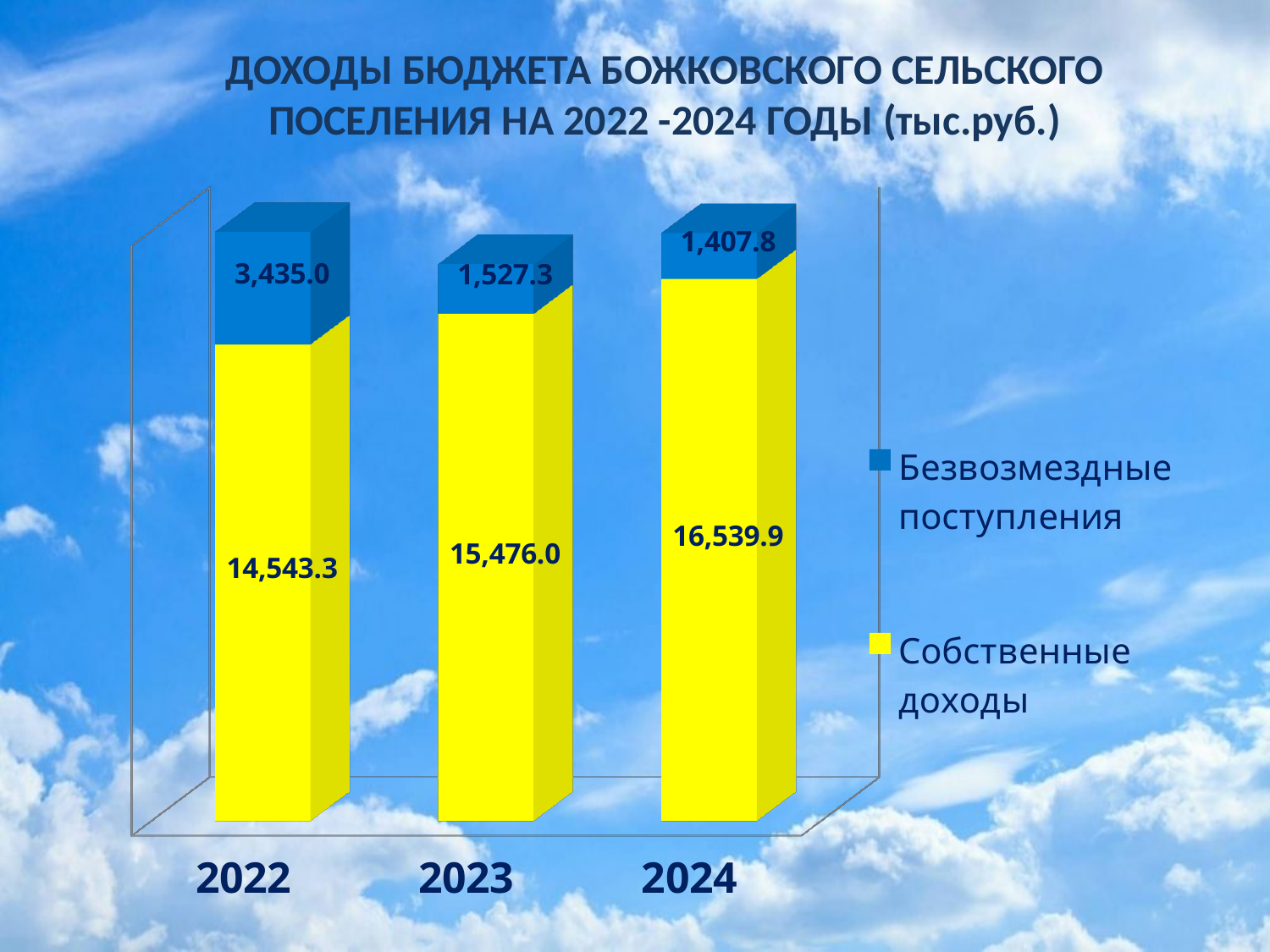
How many years are shown on the x axis? 3 In which year is Собственные доходы the highest? 2024 What is the value of Безвозмездные поступления for 2023? 1,527.3 What is the difference between Собственные доходы in 2024 and in 2022? 1,996.6 What is the value of Безвозмездные поступления for 2024? 1,407.8 In which year is Безвозмездные поступления the lowest? 2024 How many series does the legend list? 2 What is the difference between Безвозмездные поступления in 2022 and in 2024? 2,027.2 What is the value of Собственные доходы for 2022? 14,543.3 Does Собственные доходы rise or fall from 2022 to 2024? rise Which is larger: Безвозмездные поступления in 2022 or in 2023? 2022 What is the total of the stacked bar for 2023? 17,003.3